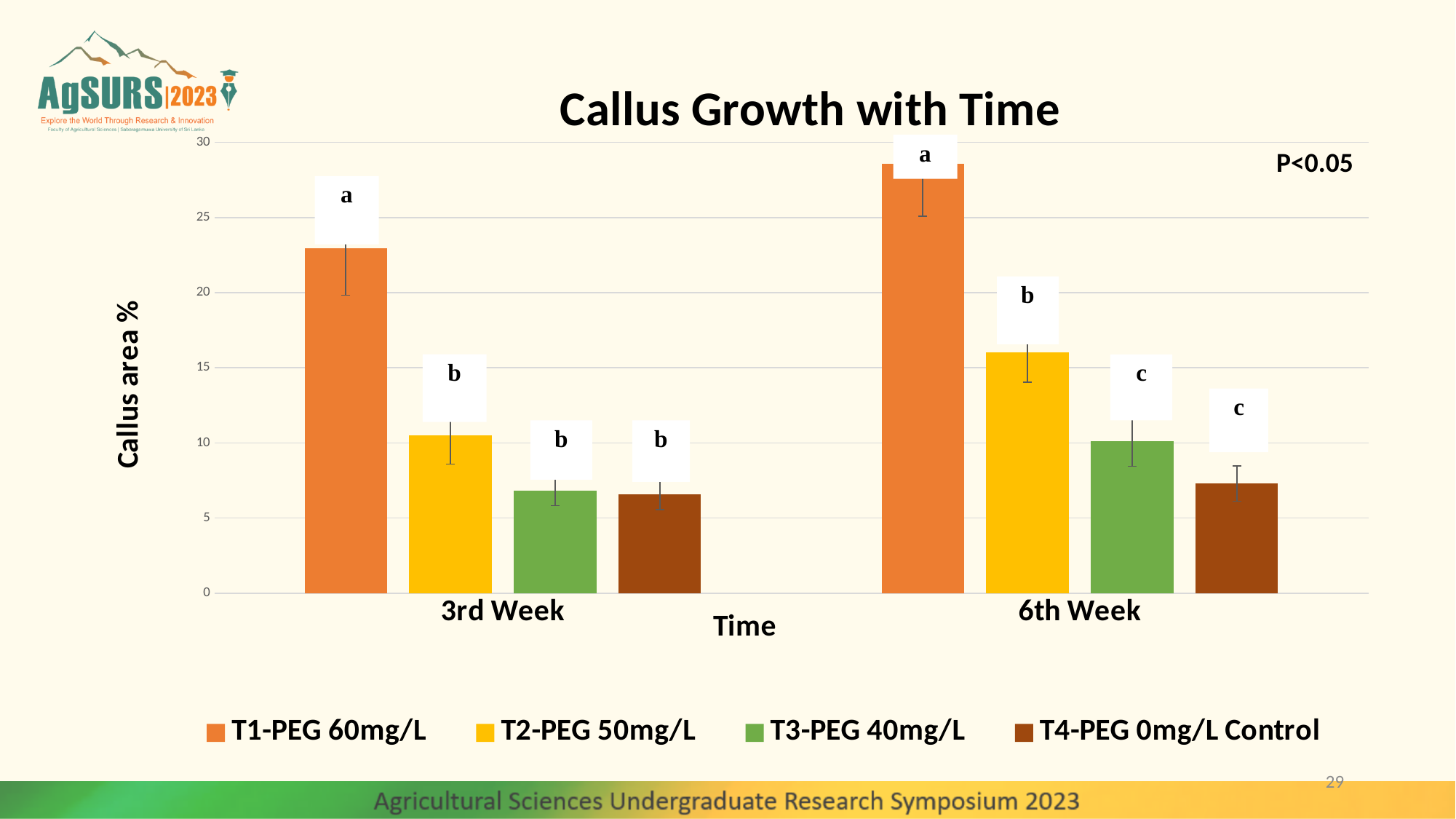
Is the callus area for T1-PEG 60mg/L larger in the 3rd Week or the 6th Week? 6th Week Which treatment has the highest callus area in the 3rd Week? T1-PEG 60mg/L Is the value for T1-PEG 60mg/L in the 3rd Week greater or less than 20? greater What kind of chart is shown on the slide? bar chart Is the value for T1-PEG 60mg/L in the 6th Week greater or less than 25? greater How many time categories are shown on the x axis? 2 Is the value for T2-PEG 50mg/L in the 6th Week greater or less than 10? greater Which treatment has the lowest callus area in the 6th Week? T4-PEG 0mg/L Control What is the title of the chart? Callus Growth with Time Which treatment has the highest callus area in the 6th Week? T1-PEG 60mg/L How many series does the legend list? 4